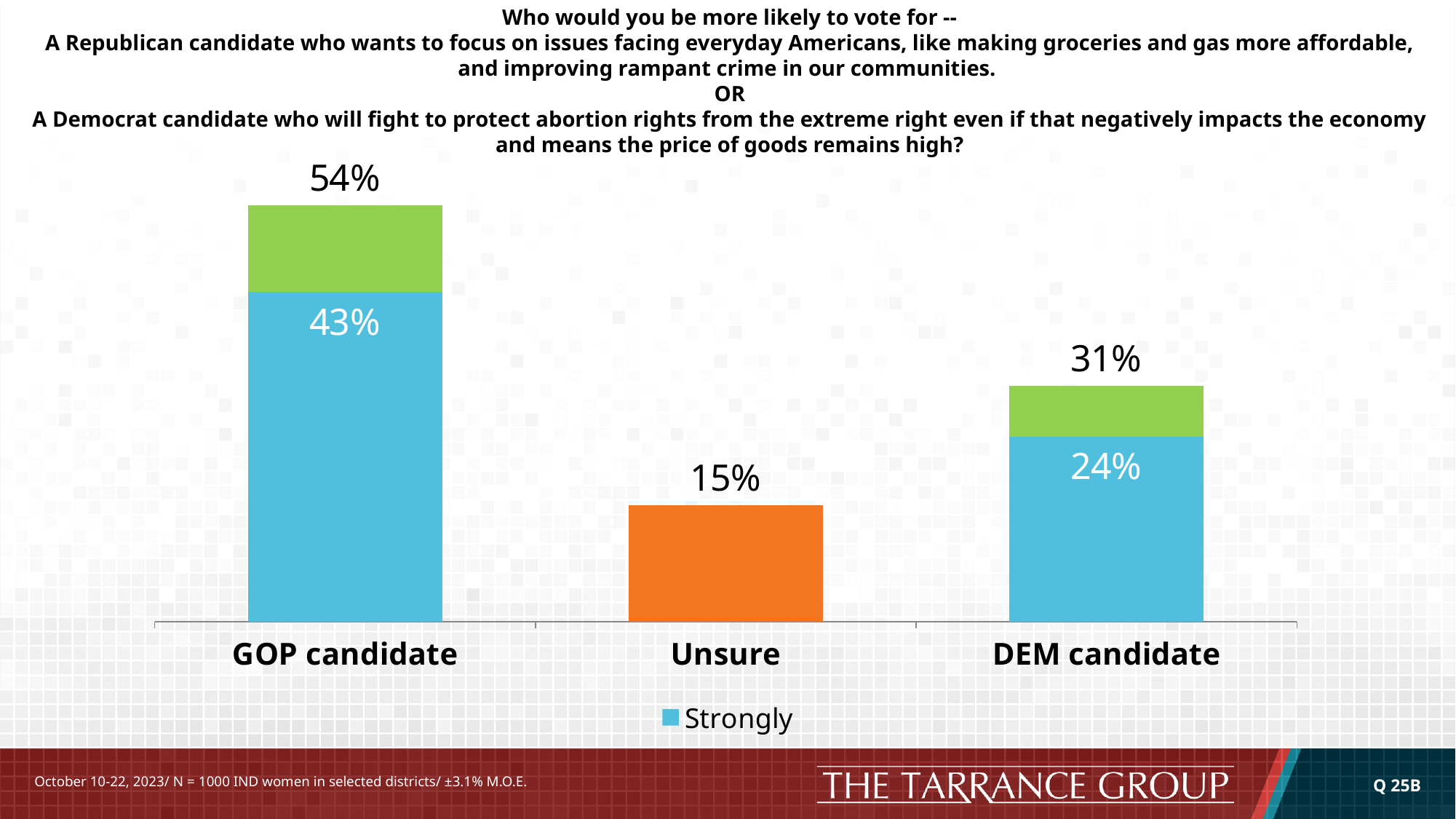
What is the Strongly value for GOP candidate? 43% What is the total value shown for DEM candidate? 31% What is the difference between the Strongly value for GOP candidate and the Strongly value for DEM candidate? 19% What kind of chart is shown on the slide? Bar chart What is the Strongly value for DEM candidate? 24% Which is larger, the total for DEM candidate or the value for Unsure? DEM candidate Which category has the lowest value? Unsure Which category has the highest total value? GOP candidate What is the value shown for Unsure? 15% What is the total value shown for GOP candidate? 54% How many categories are shown on the x axis? 3 What is the difference between the total for GOP candidate and the total for DEM candidate? 23%